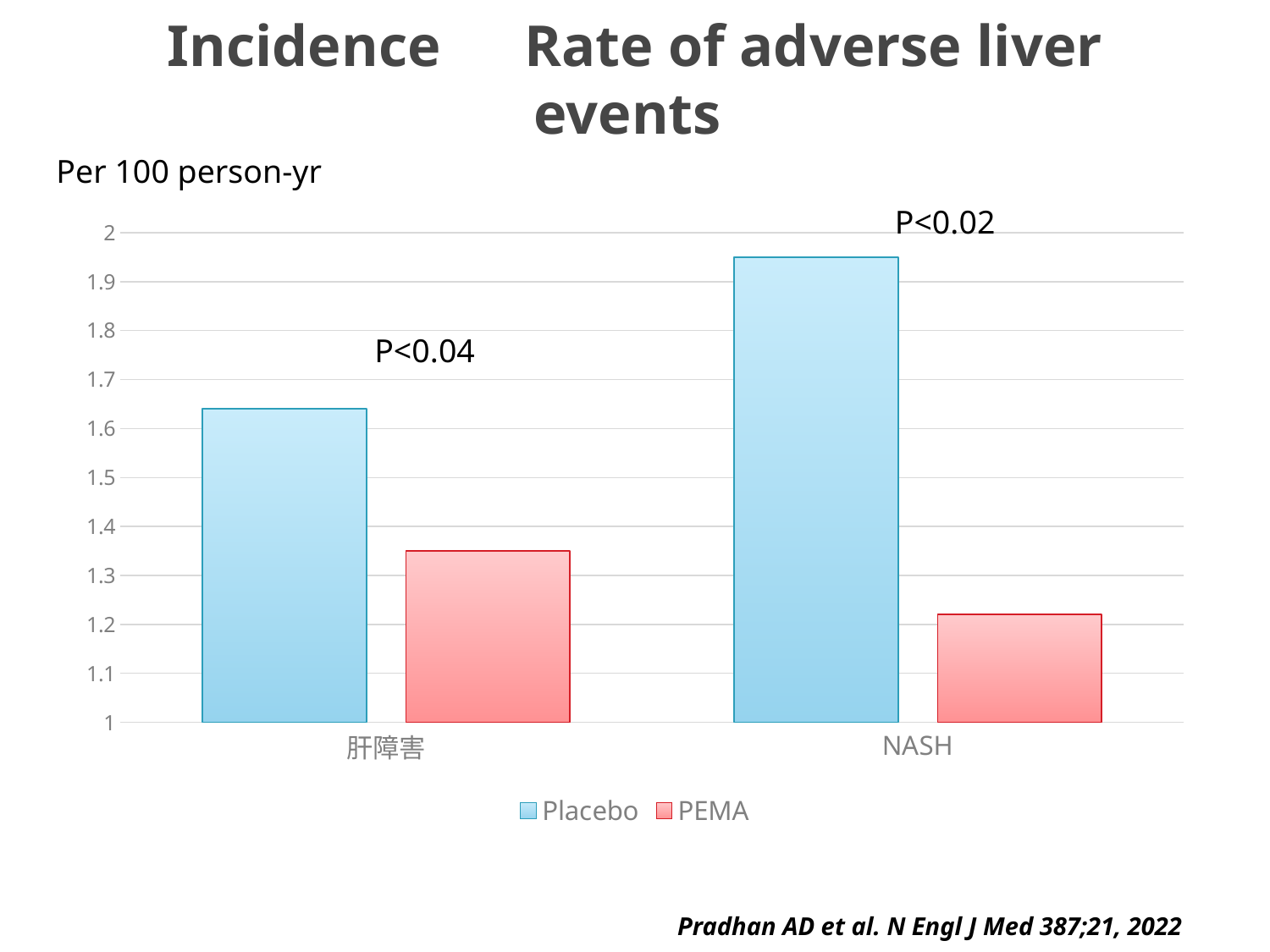
Is the PEMA value for NASH greater or less than 1.3? less How many categories are shown on the x axis? 2 For NASH, which is larger, Placebo or PEMA? Placebo Is the Placebo value for 肝障害 greater or less than 1.5? greater Is the PEMA value for 肝障害 greater or less than 1.4? less Which series and category has the lowest bar? PEMA, NASH What P value is annotated above the NASH bars? P<0.02 Which series and category has the highest bar? Placebo, NASH What kind of chart is shown on the slide? bar chart How many series does the legend list? 2 For 肝障害, which is larger, Placebo or PEMA? Placebo